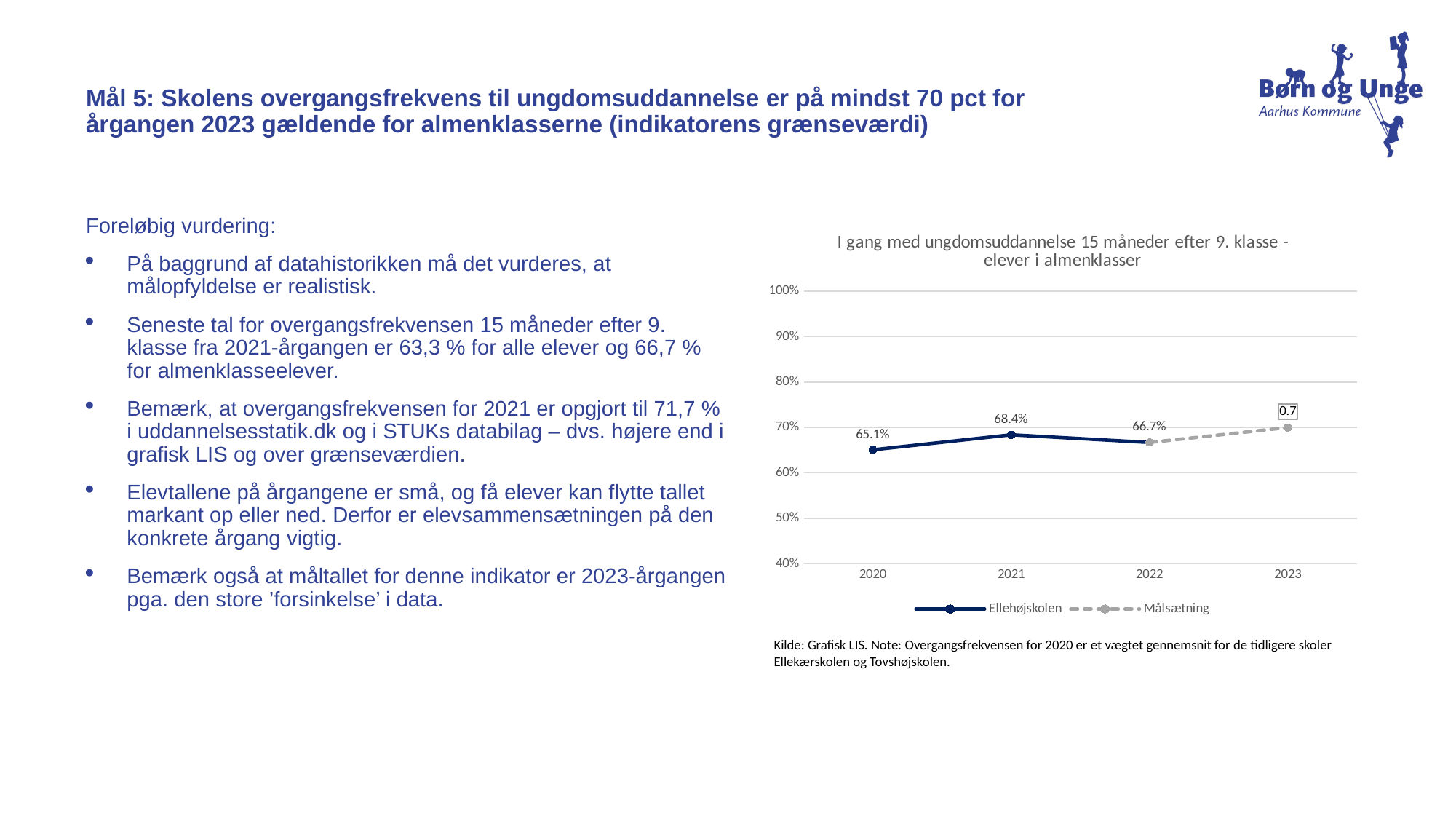
What is the value for Ellehøjskolen in 2021? 68.4% What kind of chart is shown on the slide? line chart What is the value for Ellehøjskolen in 2020? 65.1% What data label is shown for the Målsætning series in 2023? 0.7 How many years are shown on the x axis? 4 What is the value for Ellehøjskolen in 2022? 66.7% In which year is the Ellehøjskolen value lowest? 2020 What is the difference between the Ellehøjskolen values for 2021 and 2020? 3.3 percentage points Is the Ellehøjskolen value for 2020 greater or less than 70%? less Which is larger, the Ellehøjskolen value for 2021 or for 2022? 2021 In which year is the Ellehøjskolen value highest? 2021 How many series does the legend list? 2